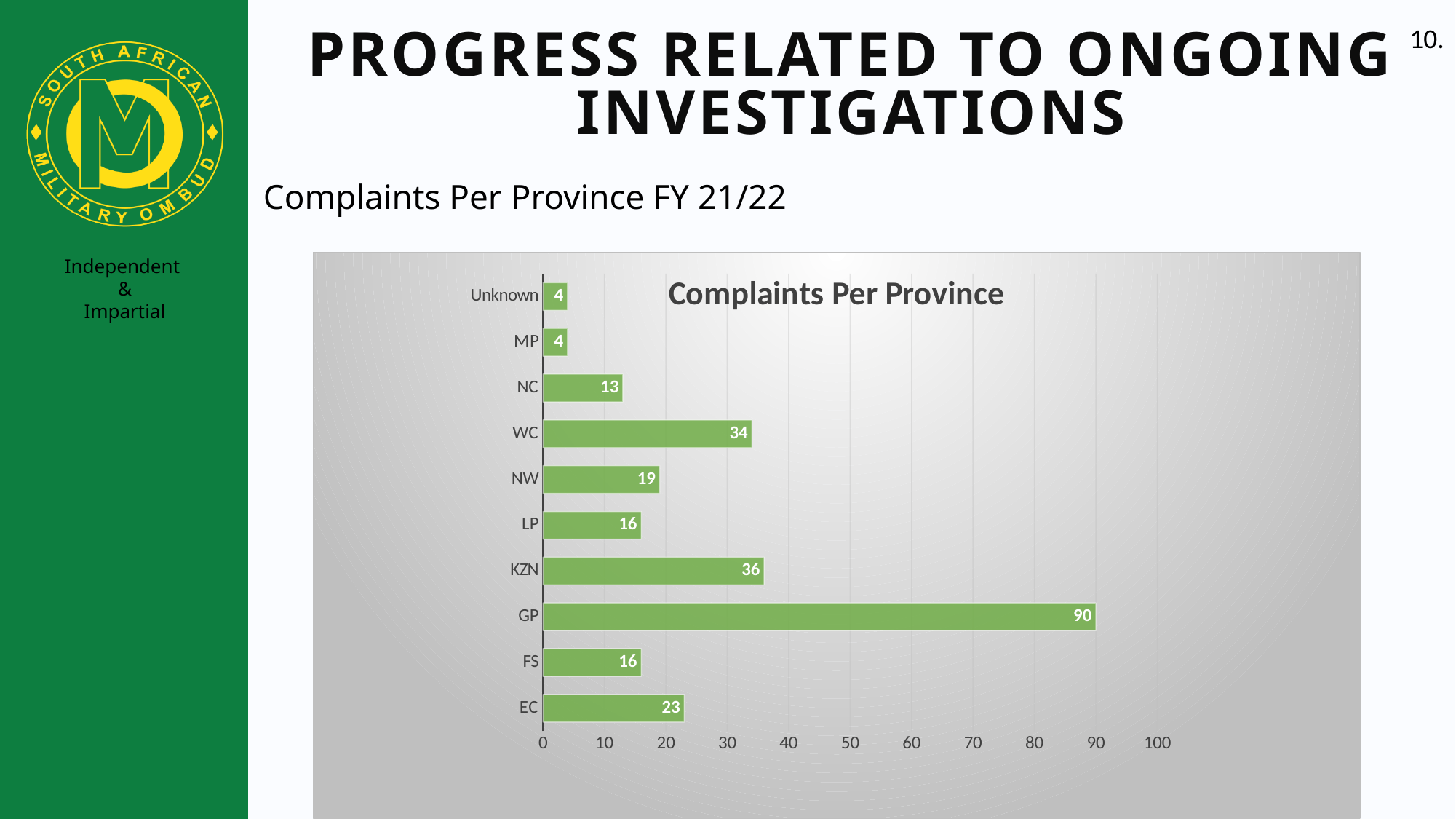
What is the value for WC? 34 What is the value for GP in the Complaints Per Province chart? 90 Which province has the highest number of complaints? GP What kind of chart is shown on the slide? Bar chart Which is larger, the value for NW or the value for LP? NW How many categories are shown in the Complaints Per Province chart? 10 What is the title of the chart? Complaints Per Province What is the difference between the values for WC and NC? 21 What is the difference between the values for GP and KZN? 54 How many complaints are shown for KZN? 36 What is the value for EC? 23 Which is larger, the value for EC or the value for FS? EC